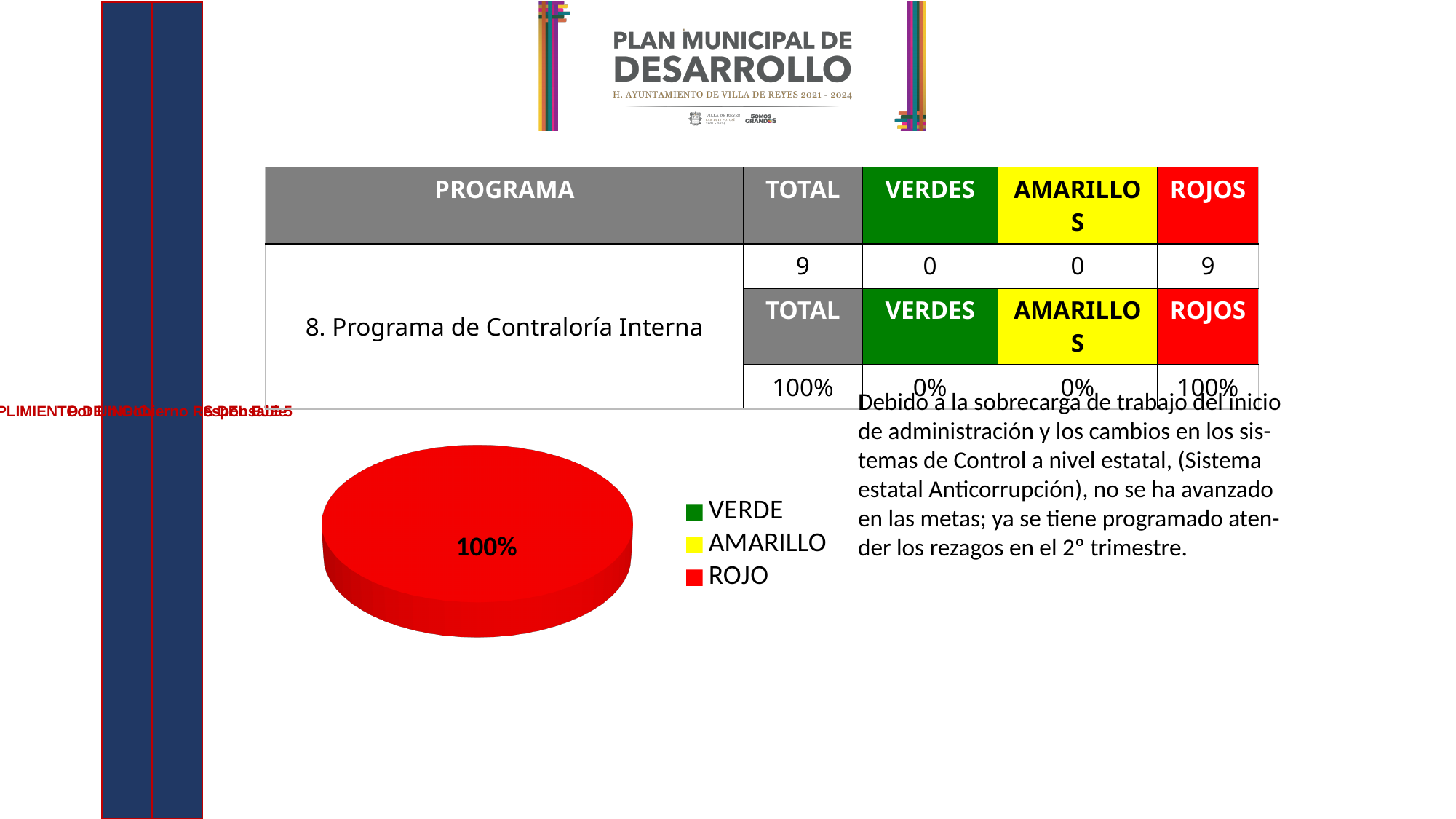
Which category has the largest slice in the pie chart? ROJO What is the data label printed on the pie chart? 100% Is the share of the ROJO slice in the pie chart greater or less than 50%? greater What kind of chart is shown on the slide? pie chart How many slices are visibly drawn in the pie chart? 1 Which legend entry of the pie chart is shown in yellow? AMARILLO How many entries does the legend of the pie chart list? 3 What share of the pie chart does the ROJO slice represent? 100% What colour is the ROJO slice in the pie chart? red